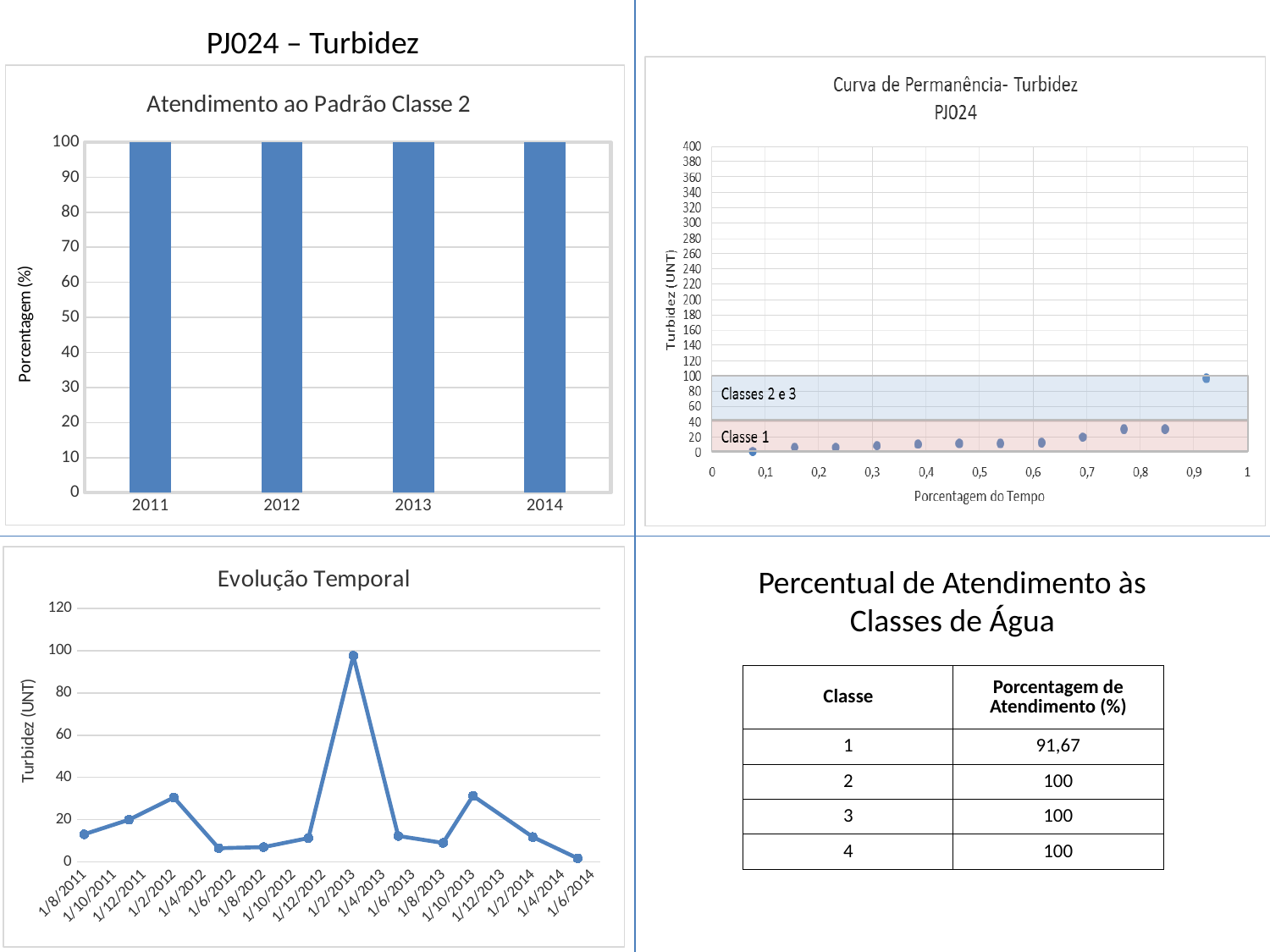
What kind of chart is "Atendimento ao Padrão Classe 2"? bar chart How many years are shown in the "Atendimento ao Padrão Classe 2" chart? 4 What kind of chart is "Evolução Temporal"? line chart In the "Curva de Permanência- Turbidez PJ024" chart, what is the x-axis title? Porcentagem do Tempo In the "Evolução Temporal" chart, which is larger, the value at 1/8/2011 or the value at 1/12/2011? 1/12/2011 In the "Evolução Temporal" chart, is the value at 1/2/2013 greater or less than 80? greater In the "Curva de Permanência- Turbidez PJ024" chart, is the value of the rightmost point (near 0,9) greater or less than 80? greater In the "Evolução Temporal" chart, is the value at 1/6/2014 greater or less than 20? less In the "Atendimento ao Padrão Classe 2" chart, what is the value for 2012? 100 In the "Evolução Temporal" chart, which date has the lowest turbidity value? 1/6/2014 In the "Atendimento ao Padrão Classe 2" chart, what is the y-axis title? Porcentagem (%) In the "Evolução Temporal" chart, which date has the highest turbidity value? 1/2/2013